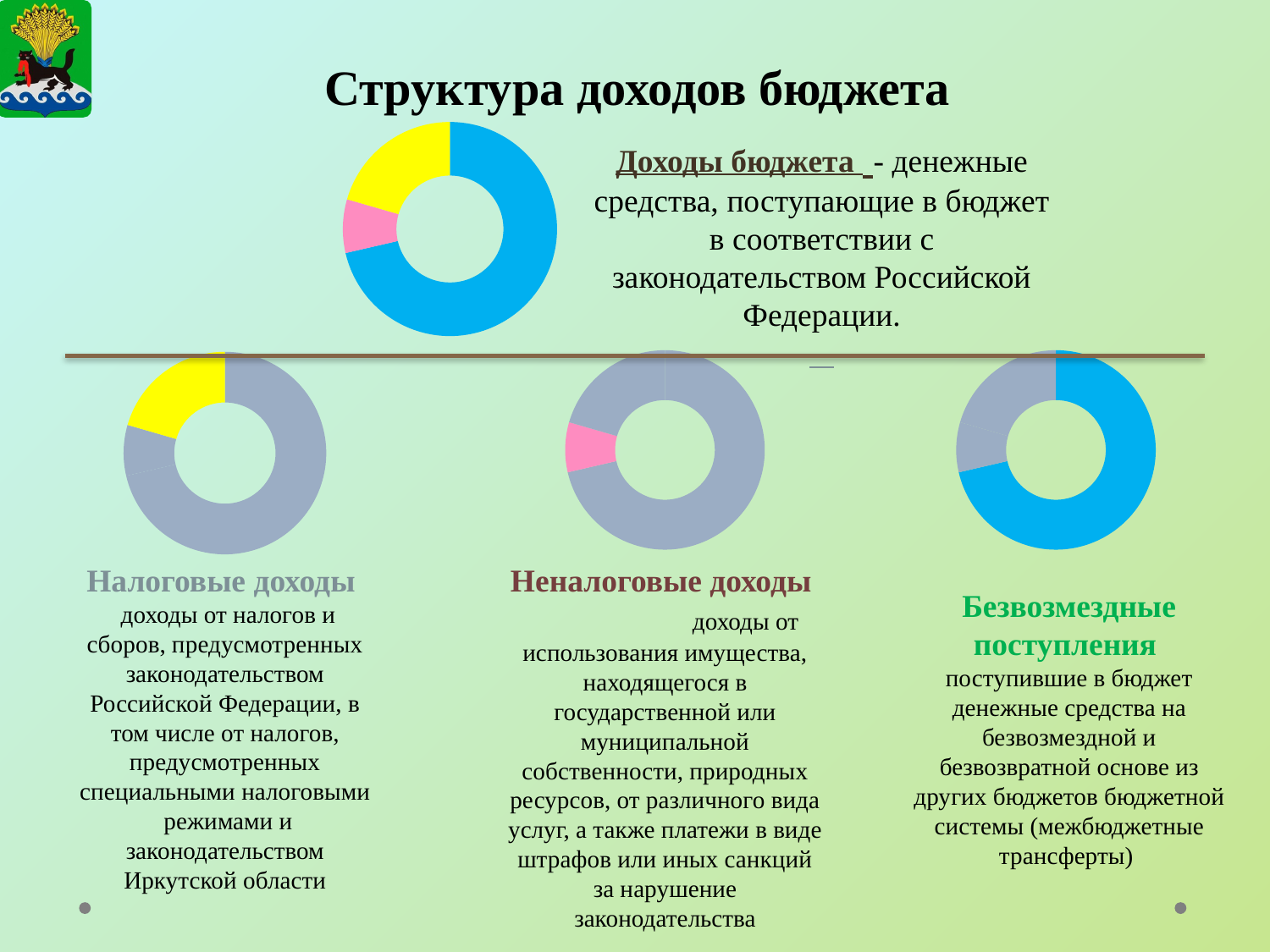
In the top pie chart, which colour slice is the smallest? pink Which colour is highlighted in the chart above 'Налоговые доходы'? yellow In the top pie chart, which colour slice is the largest? blue In the chart above 'Безвозмездные поступления', is the highlighted blue slice larger or smaller than the grey remainder? larger In the top pie chart, which slice is larger, the yellow one or the pink one? yellow In the top pie chart, which slice is larger, the blue one or the yellow one? blue Based on the colours used in the lower charts, which revenue category has the largest share in the top pie chart? Безвозмездные поступления How many slices does the top pie chart have? 3 How many pie (donut) charts are shown on the slide? 4 What kind of chart is the chart at the top of the slide, next to the definition of 'Доходы бюджета'? pie chart (donut) Which colour is highlighted in the chart above 'Безвозмездные поступления'? blue